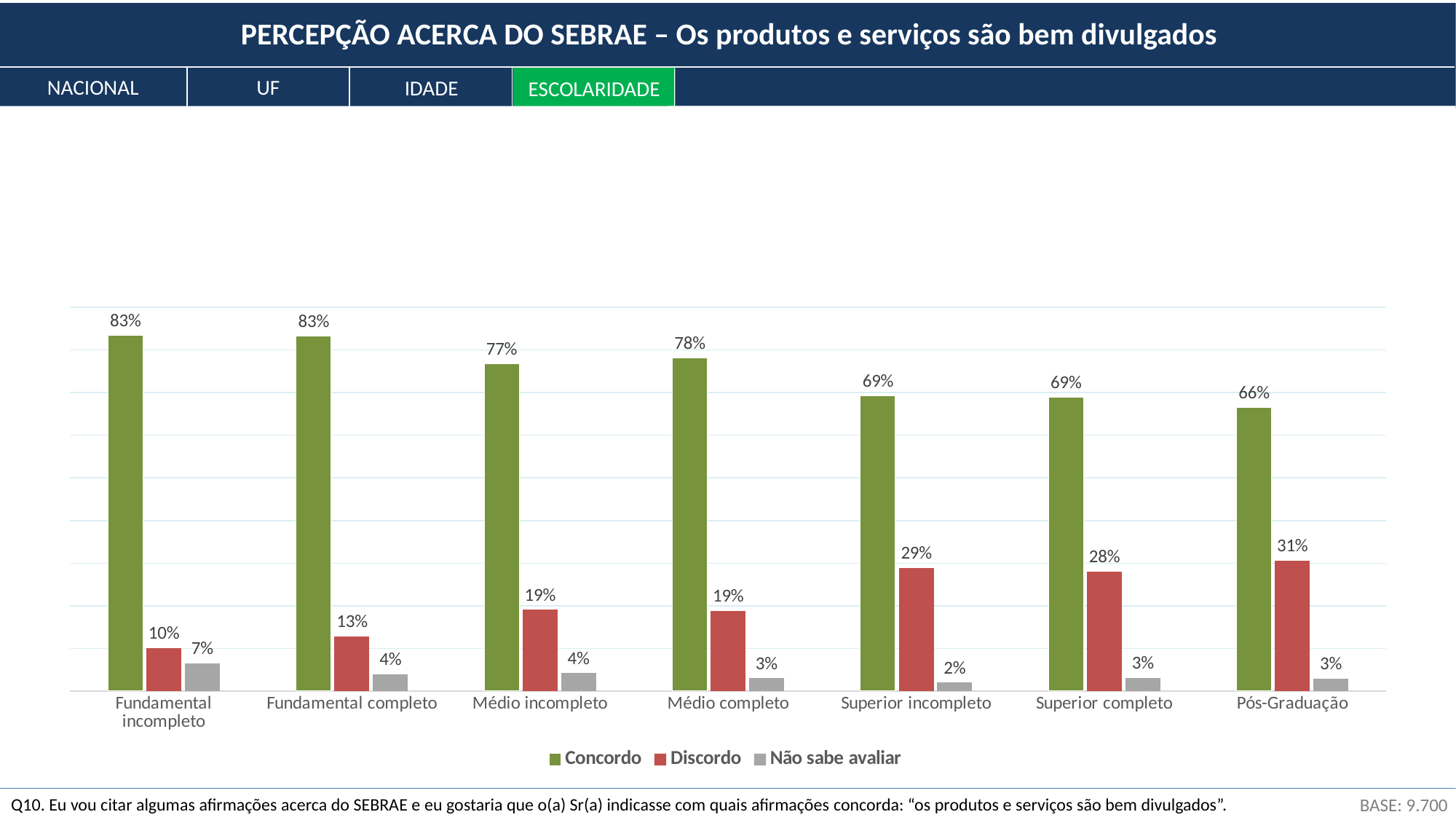
What kind of chart is shown on the slide? Bar chart Which is larger, the Discordo value for Médio incompleto or for Superior completo? Superior completo What is the difference between the Concordo values for Fundamental completo and Pós-Graduação? 17% How many series does the legend list? 3 What is the Concordo value for Médio completo? 78% What is the Não sabe avaliar value for Fundamental incompleto? 7% Which colour represents the Discordo series in the legend? Red Do the Concordo values generally rise or fall from Fundamental incompleto to Pós-Graduação? Fall Which category has the lowest Não sabe avaliar value? Superior incompleto Which category has the highest Discordo value? Pós-Graduação How many education categories are shown on the x axis? 7 What is the Discordo value for Superior incompleto? 29%